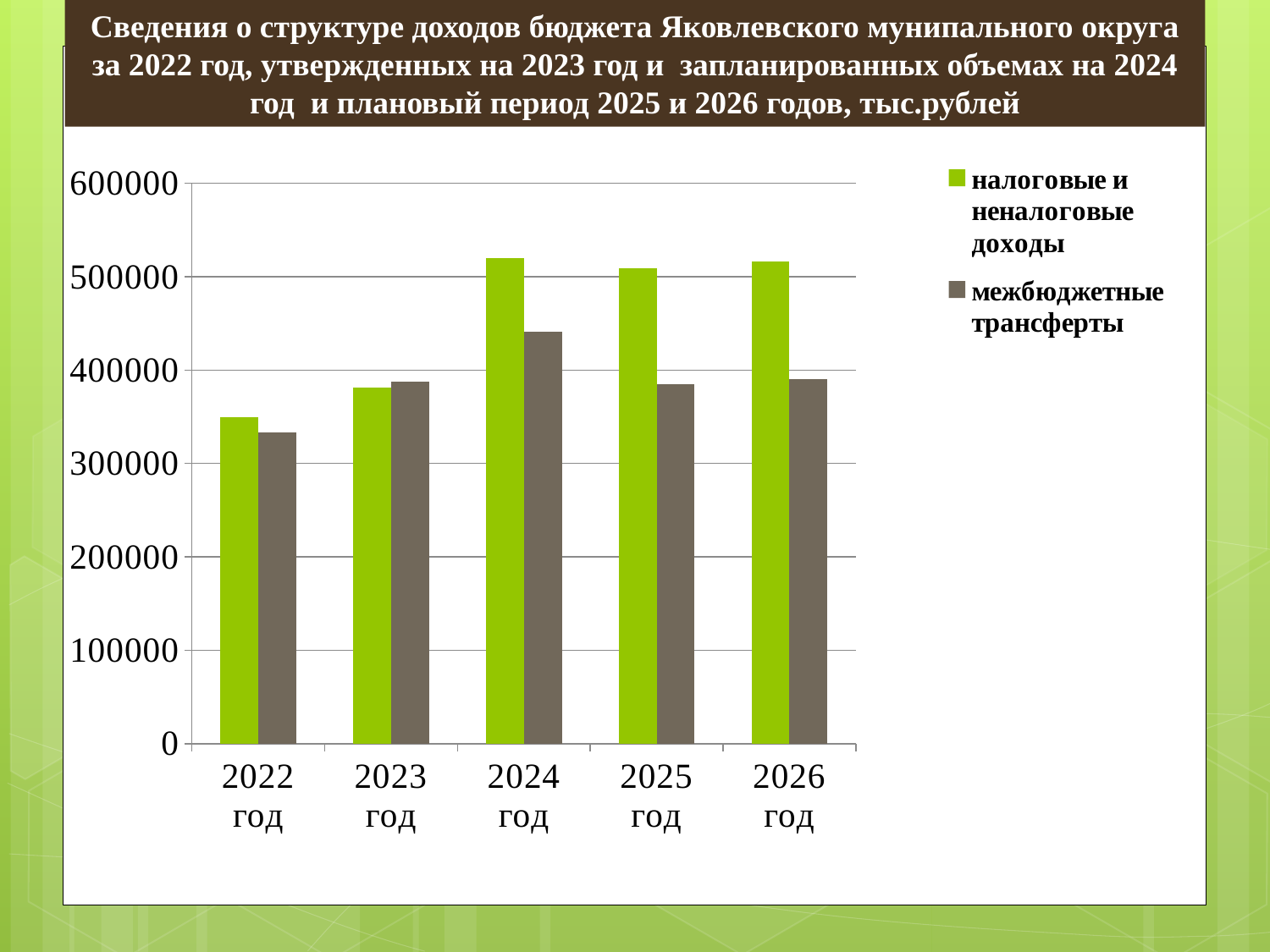
What kind of chart is shown on the slide? bar chart Does the value for межбюджетные трансферты rise or fall from 2022 год to 2024 год? rise Is the value for налоговые и неналоговые доходы in 2023 год greater or less than 400000? less Is the value for налоговые и неналоговые доходы in 2024 год greater or less than 500000? greater Which year has the lowest value for межбюджетные трансферты? 2022 год What colour are the bars for межбюджетные трансферты? grey How many series does the legend list? 2 Is the value for межбюджетные трансферты in 2025 год greater or less than 400000? less Which year has the highest value for межбюджетные трансферты? 2024 год How many year categories are shown on the x axis? 5 Which year has the lowest value for налоговые и неналоговые доходы? 2022 год In 2024 год, which is larger: налоговые и неналоговые доходы or межбюджетные трансферты? налоговые и неналоговые доходы